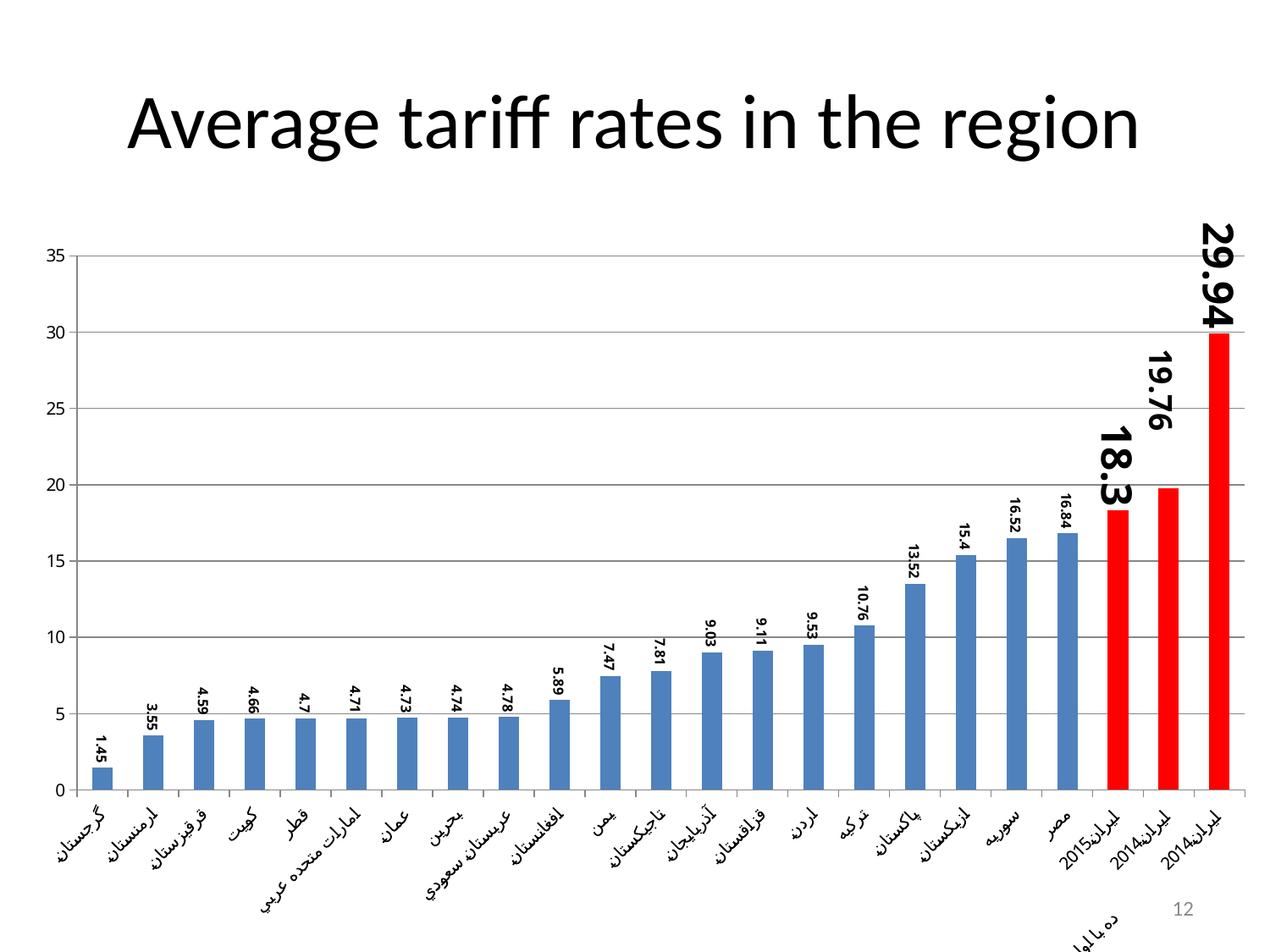
What is the value for ترکیه? 10.76 What is the value for پاکستان? 13.52 What is the value for مصر? 16.84 Is the value for افغانستان greater or less than 5? greater What is the highest value shown in the chart? 29.94 Which category has the lowest value? گرجستان Which is larger, the value for سوریه or the value for ازبکستان? سوریه What is the title of the chart? Average tariff rates in the region How many bars are coloured red? 3 What type of chart is shown on the slide? bar chart How many bars are plotted in the chart? 23 What is the difference between the values for ایران2015 and مصر? 1.46